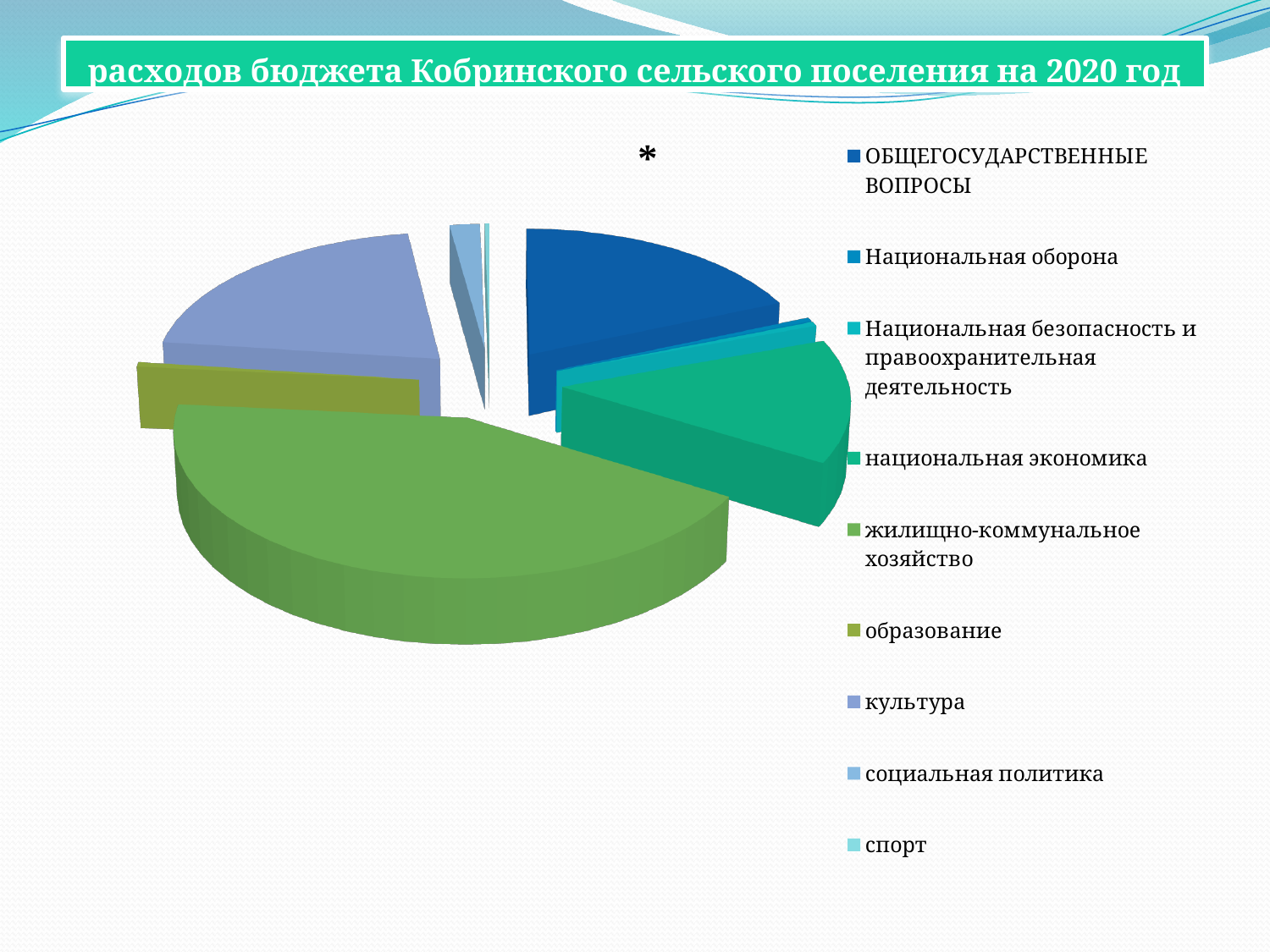
Which slice is larger: национальная экономика or образование? национальная экономика Which slice is larger: жилищно-коммунальное хозяйство or культура? жилищно-коммунальное хозяйство On which side of the chart is the legend placed? right Which slice is larger: культура or социальная политика? культура Which category has the smallest slice in the pie chart? спорт What is the first entry listed in the legend of the pie chart? ОБЩЕГОСУДАРСТВЕННЫЕ ВОПРОСЫ What kind of chart is shown on the slide? pie chart Which category has the largest slice in the pie chart? жилищно-коммунальное хозяйство How many categories does the legend of the pie chart list? 9